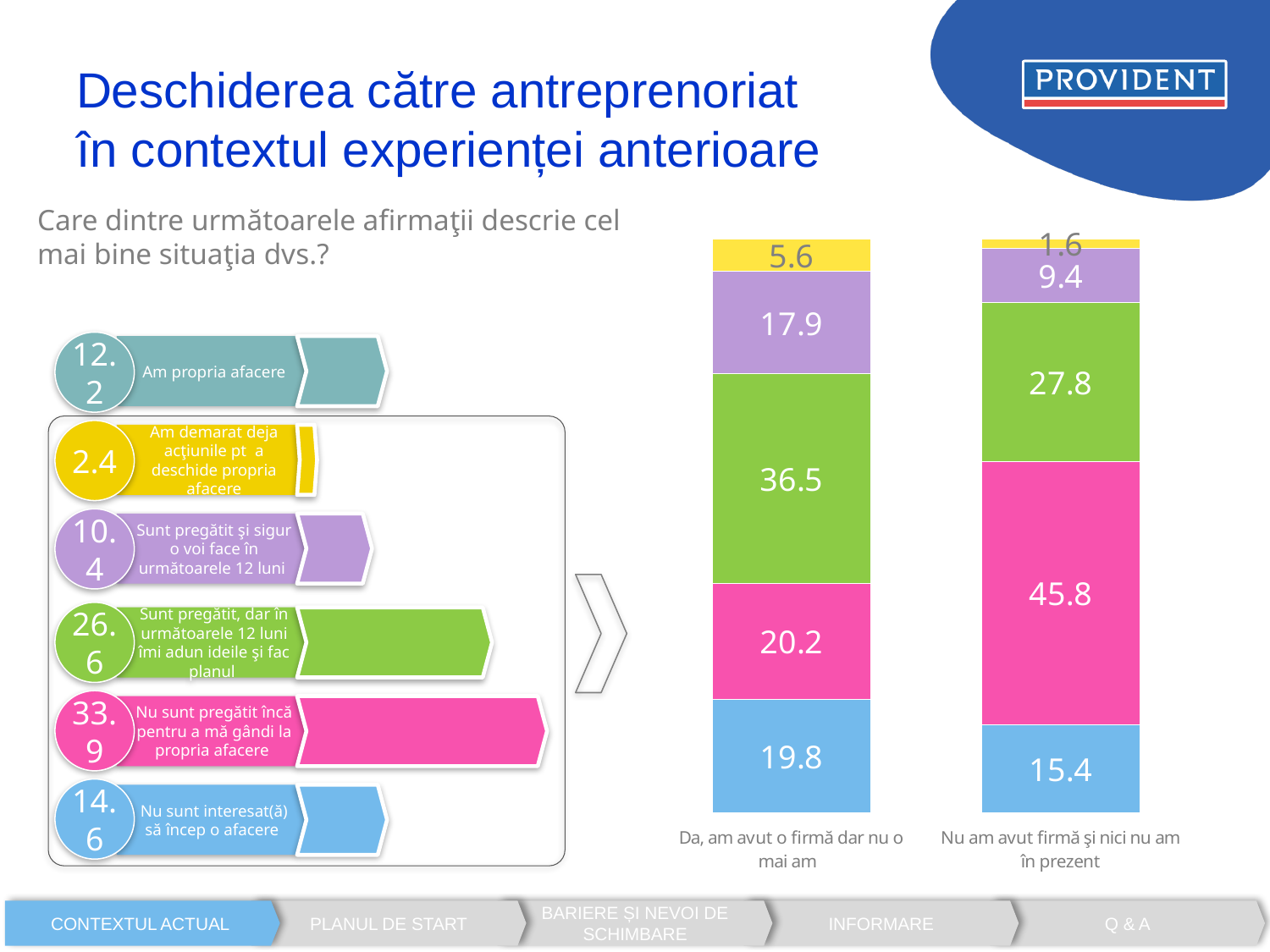
How many segments make up each stacked bar in the chart? 5 How many bars (categories) does the chart show? 2 What is the value of the blue (bottom) segment in the bar for "Da, am avut o firmă dar nu o mai am"? 19.8 What is the value of the green segment in the bar for "Da, am avut o firmă dar nu o mai am"? 36.5 What is the value of the pink segment in the bar for "Nu am avut firmă şi nici nu am în prezent"? 45.8 Which bar has the larger green segment: "Da, am avut o firmă dar nu o mai am" or "Nu am avut firmă şi nici nu am în prezent"? Da, am avut o firmă dar nu o mai am Which segment is the largest in the bar for "Nu am avut firmă şi nici nu am în prezent"? the pink segment (45.8) What is the difference between the purple segment values of the two bars (17.9 and 9.4)? 8.5 Which segment is the smallest in the bar for "Da, am avut o firmă dar nu o mai am"? the yellow segment (5.6) What is the total of all segments in the bar for "Da, am avut o firmă dar nu o mai am"? 100 What is the value of the yellow (top) segment in the bar for "Nu am avut firmă şi nici nu am în prezent"? 1.6 What type of chart is shown on the right of the slide? stacked bar chart